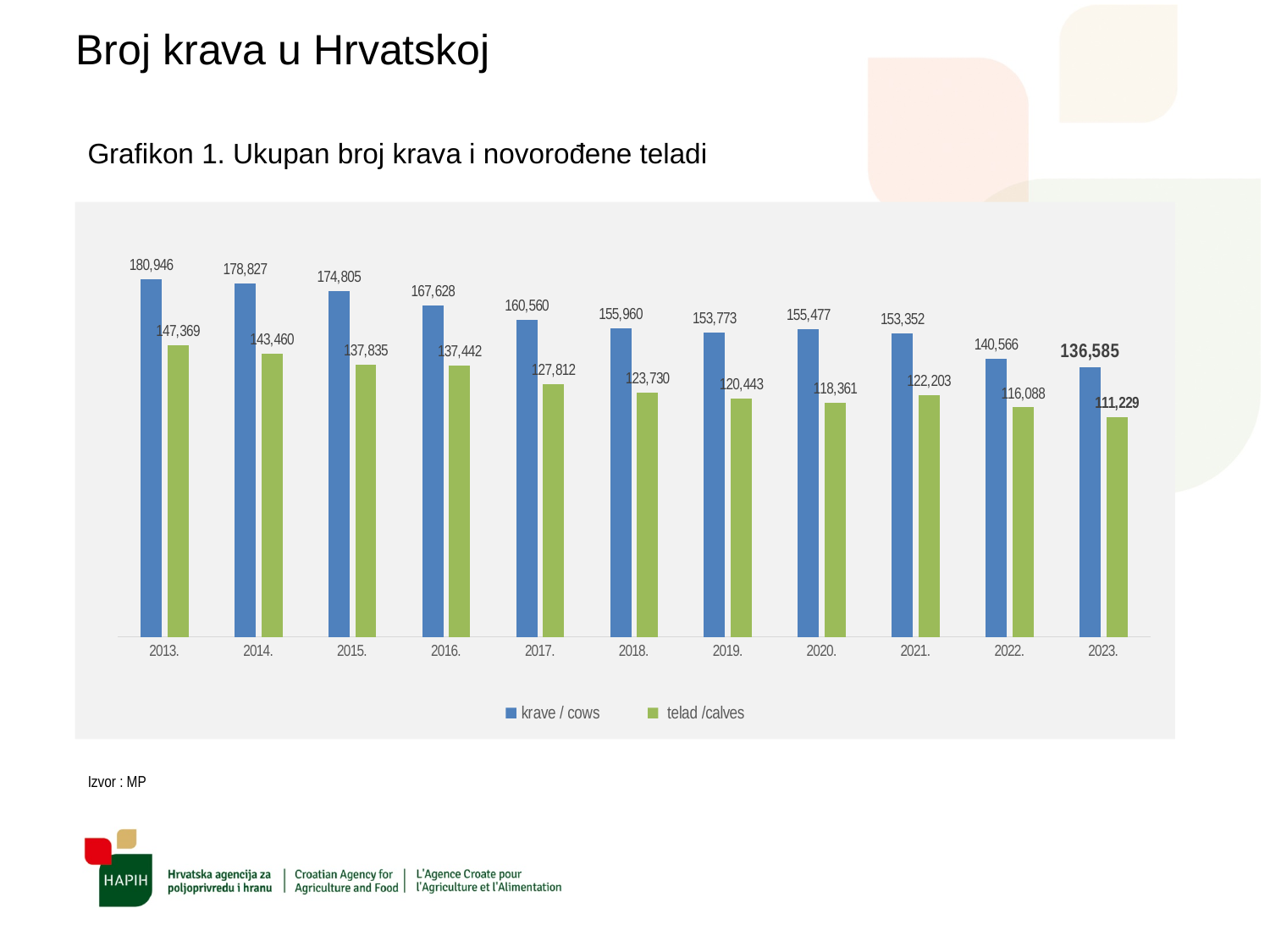
What kind of chart is shown on the slide? Bar chart What is the number of calves (telad / calves) in 2023? 111,229 What is the number of cows (krave / cows) in 2013? 180,946 By how much did the number of cows (krave / cows) fall from 2013 to 2023? 44,361 Which is larger, the number of calves in 2021 or in 2020? 2021 In which year is the number of calves (telad / calves) lowest? 2023. What is the number of cows (krave / cows) in 2020? 155,477 Does the number of cows (krave / cows) generally rise or fall from 2013 to 2023? Fall In which year is the number of cows (krave / cows) highest? 2013. How many series does the legend list? 2 What is the difference between the number of cows and the number of calves in 2013? 33,577 How many years are shown on the x axis of the chart? 11